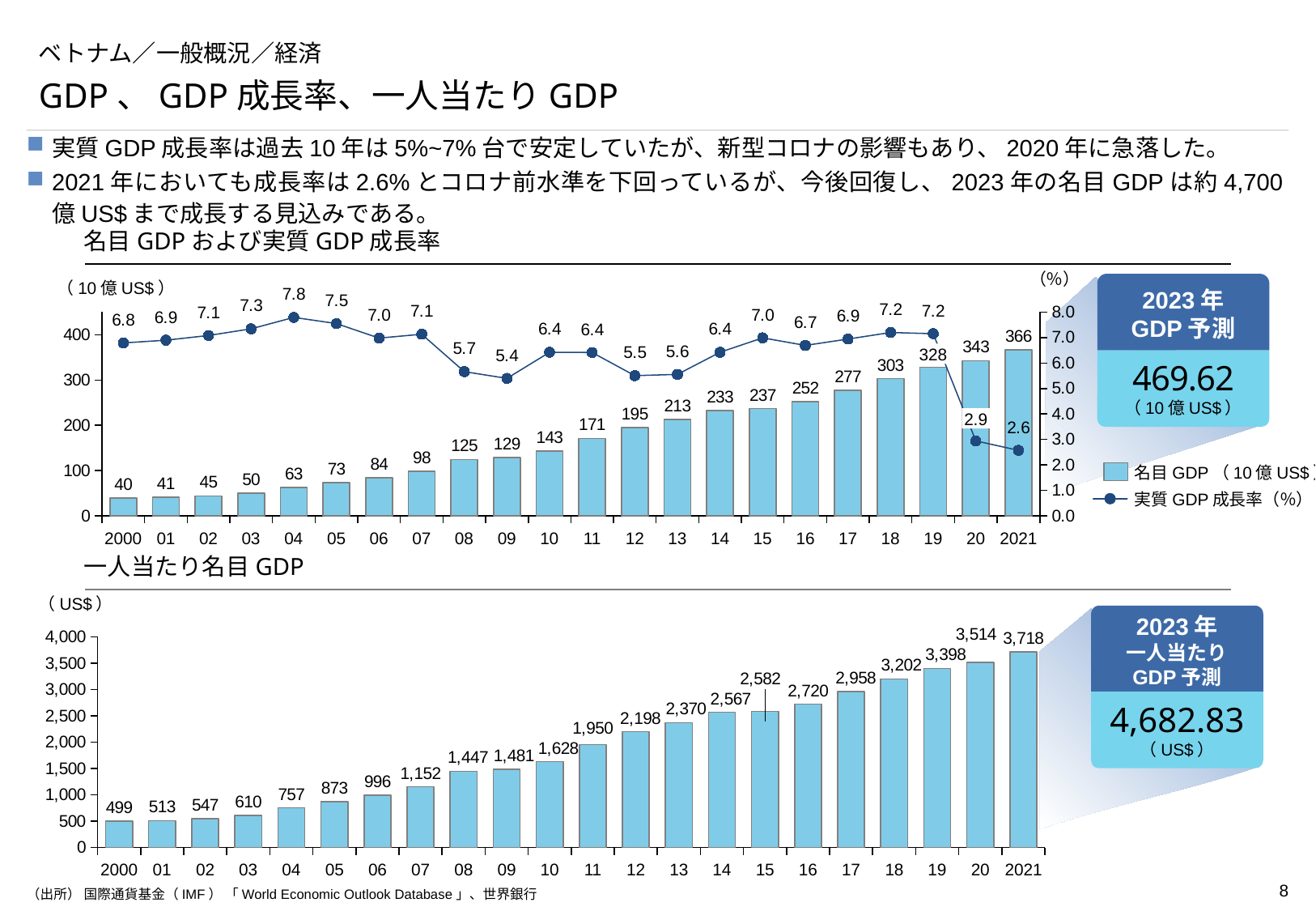
In the top chart (名目GDPおよび実質GDP成長率), what is the overall trend of nominal GDP from 2000 to 2021? Rising In the top chart (名目GDPおよび実質GDP成長率), which year has the lowest real GDP growth rate? 2021 In the bottom chart (一人当たり名目GDP), what is the difference between the values for 2021 and 2000? 3,219 What type of chart is the bottom chart (一人当たり名目GDP)? Bar chart In the bottom chart (一人当たり名目GDP), what is the value for 2021? 3,718 In the top chart (名目GDPおよび実質GDP成長率), how many series does the legend list? 2 In the top chart (名目GDPおよび実質GDP成長率), which year has the highest real GDP growth rate? 04 In the top chart (名目GDPおよび実質GDP成長率), what is the real GDP growth rate for 2004? 7.8 In the bottom chart (一人当たり名目GDP), how many years are plotted? 22 In the bottom chart (一人当たり名目GDP), which year has the lowest value? 2000 In the top chart (名目GDPおよび実質GDP成長率), what is the difference in nominal GDP between 2021 and 20? 23 In the top chart (名目GDPおよび実質GDP成長率), what is the nominal GDP value for 2021? 366